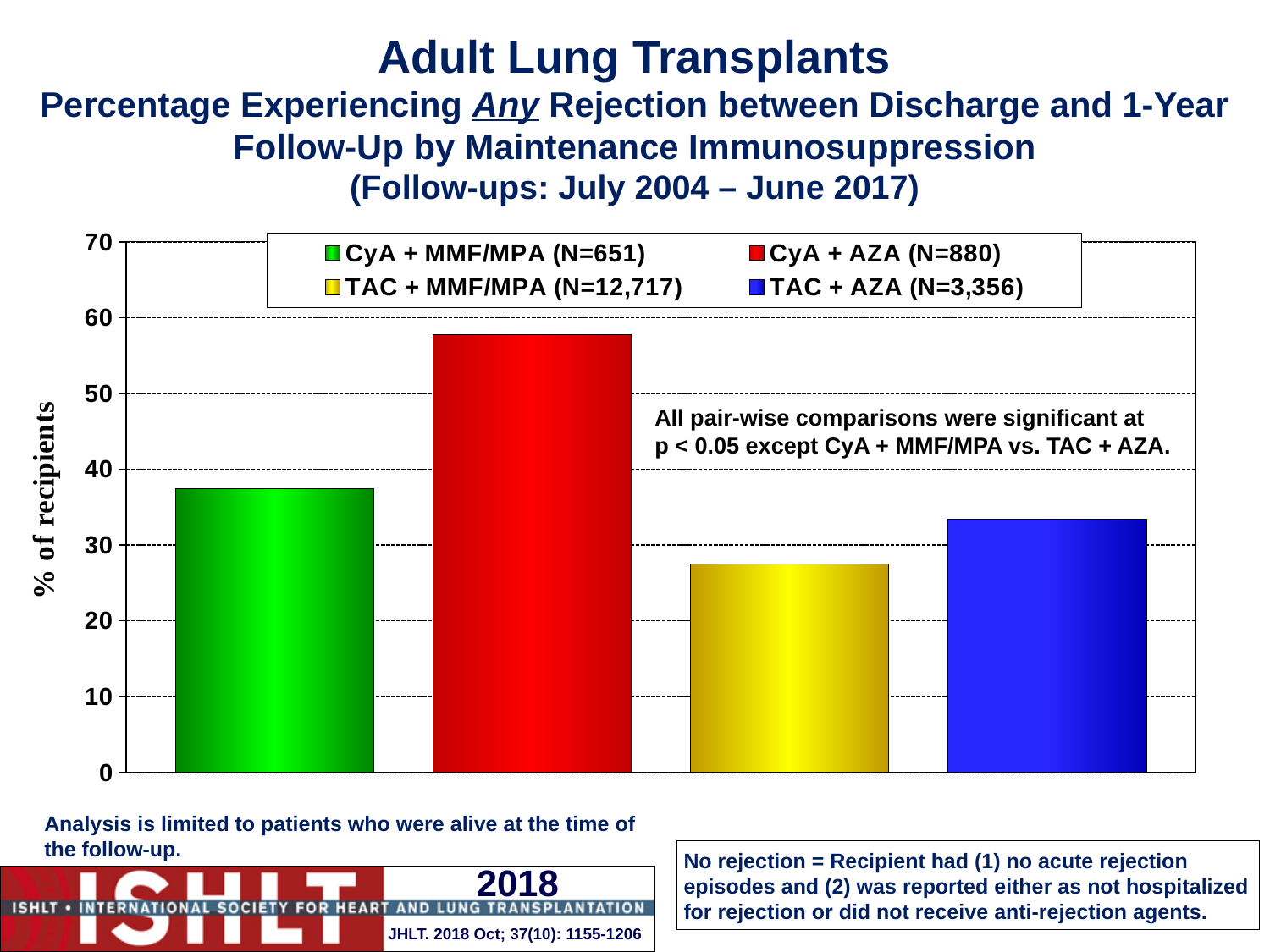
What kind of chart is shown on the slide? bar chart What colour is the bar for TAC + MMF/MPA (N=12,717)? yellow Is the value for TAC + AZA greater or less than 30? greater How many series does the legend list? 4 Is the value for CyA + AZA greater or less than 50? greater Which is larger, the value for CyA + MMF/MPA or the value for TAC + AZA? CyA + MMF/MPA Which maintenance immunosuppression group has the lowest percentage of recipients experiencing any rejection? TAC + MMF/MPA (N=12,717) What is the label on the y axis of the chart? % of recipients Which maintenance immunosuppression group has the highest percentage of recipients experiencing any rejection? CyA + AZA (N=880) Is the value for TAC + MMF/MPA greater or less than 30? less How many bars are plotted in the chart? 4